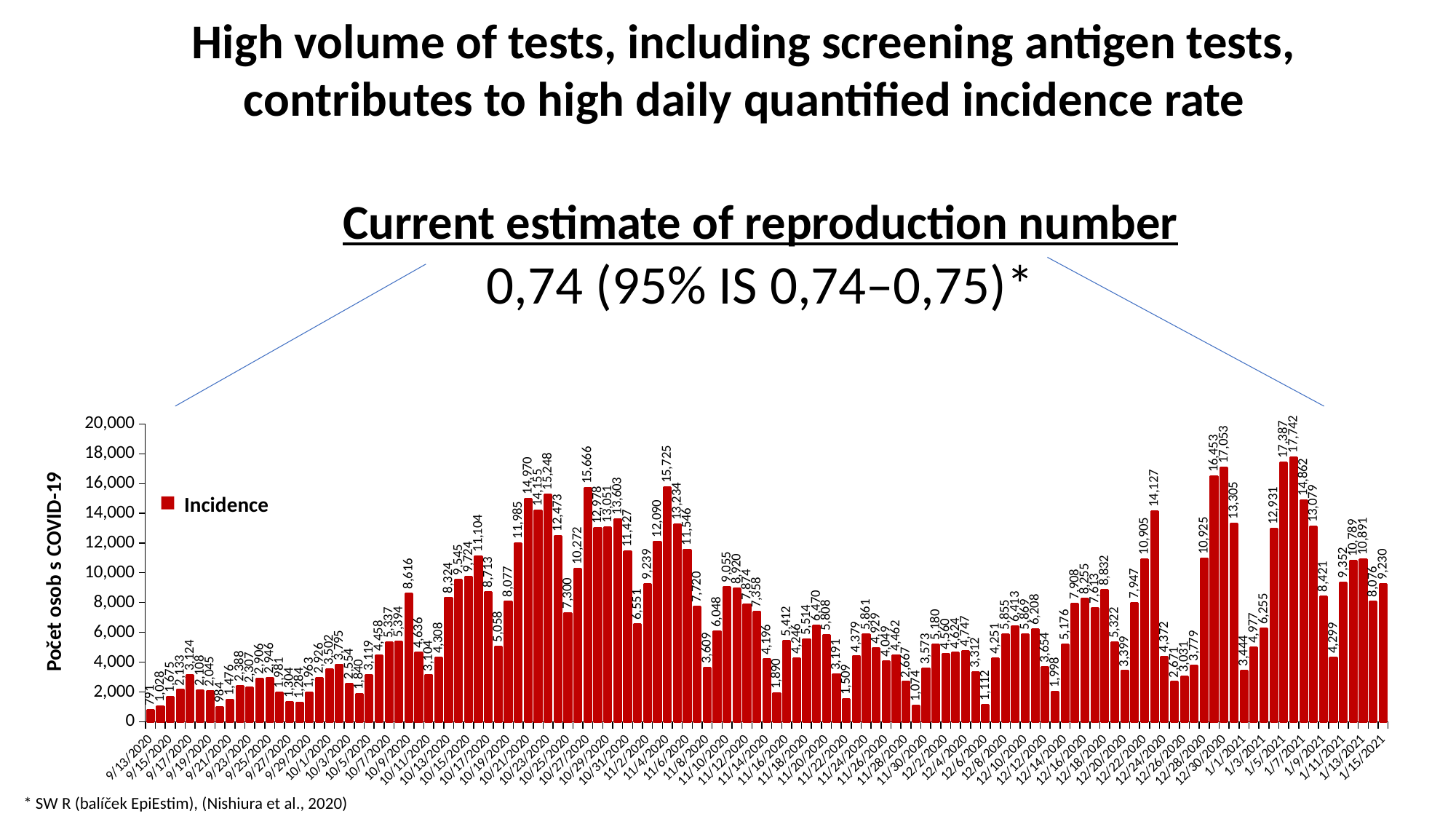
Which is larger, the incidence on 9/13/2020 or on 1/15/2021? 1/15/2021 What is the incidence value for the first bar, 9/13/2020? 791 What is the highest daily incidence value labelled on the chart? 17,742 What is the name of the series shown in the chart legend? Incidence What kind of chart is shown on the slide? bar chart Do the incidence values generally rise or fall from 9/13/2020 to 10/25/2020? rise What is the label on the vertical axis of the chart? Počet osob s COVID-19 What is the incidence value for the last bar, 1/15/2021? 9,230 How many series does the chart legend list? 1 What is the difference between the two tallest bars, labelled 17,742 and 17,387? 355 What is the difference between the incidence on 1/15/2021 (9,230) and on 9/13/2020 (791)? 8,439 Is the value for 9/13/2020 greater or less than 2,000? less